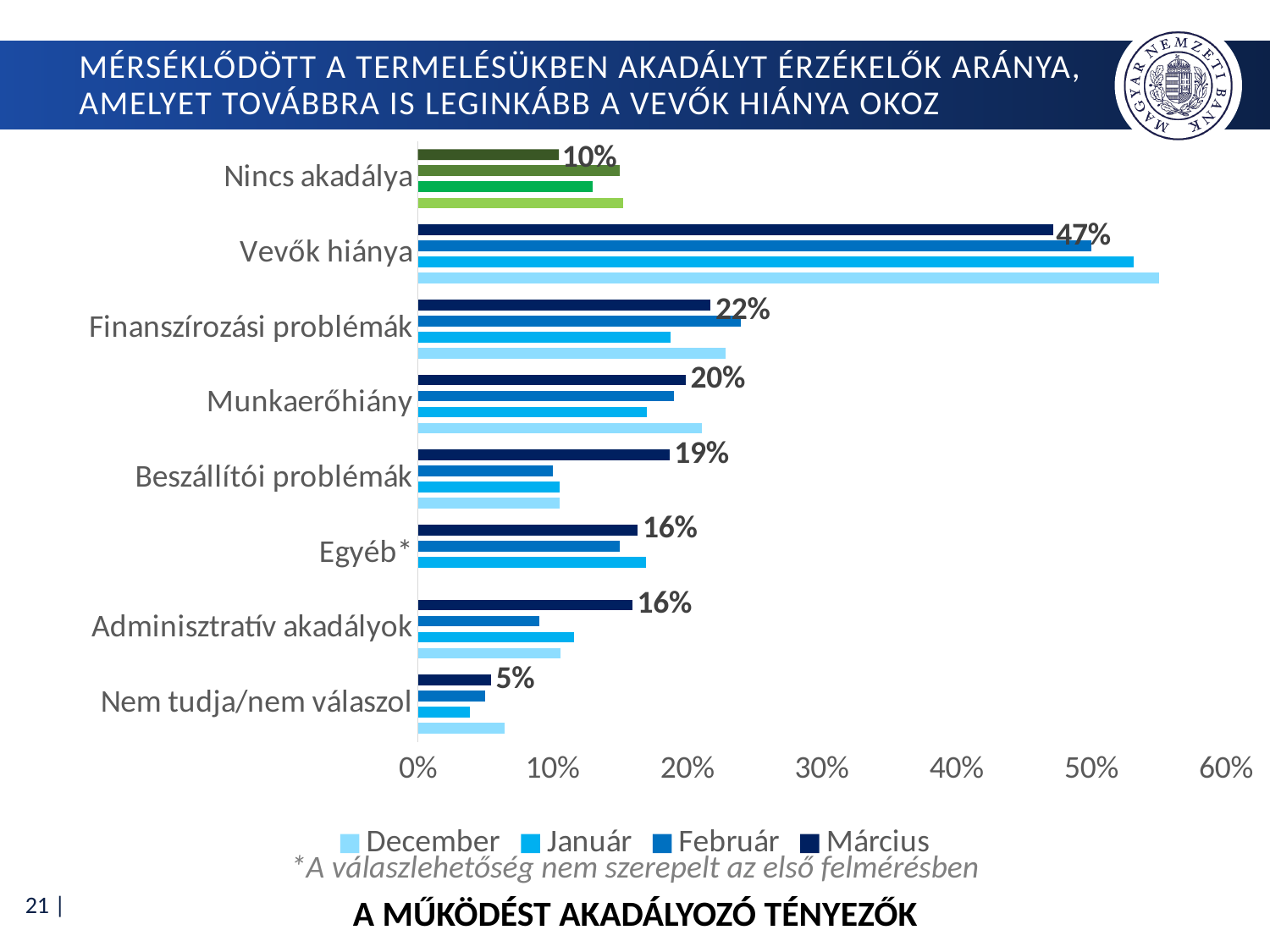
How many series does the legend list? 4 What is the Március value for Vevők hiánya? 47% What is the Március value for Nincs akadálya? 10% Which has the larger Március value: Munkaerőhiány or Beszállítói problémák? Munkaerőhiány What is the Március value for Nem tudja/nem válaszol? 5% Which category has the lowest Március value? Nem tudja/nem válaszol What kind of chart is shown on the slide? bar chart How many categories are shown on the vertical axis? 8 What is the Március value for Finanszírozási problémák? 22% What is the difference between the Március values for Vevők hiánya and Finanszírozási problémák? 25 percentage points Which category has the highest Március value? Vevők hiánya Is the December value for Vevők hiánya greater or less than 50%? greater